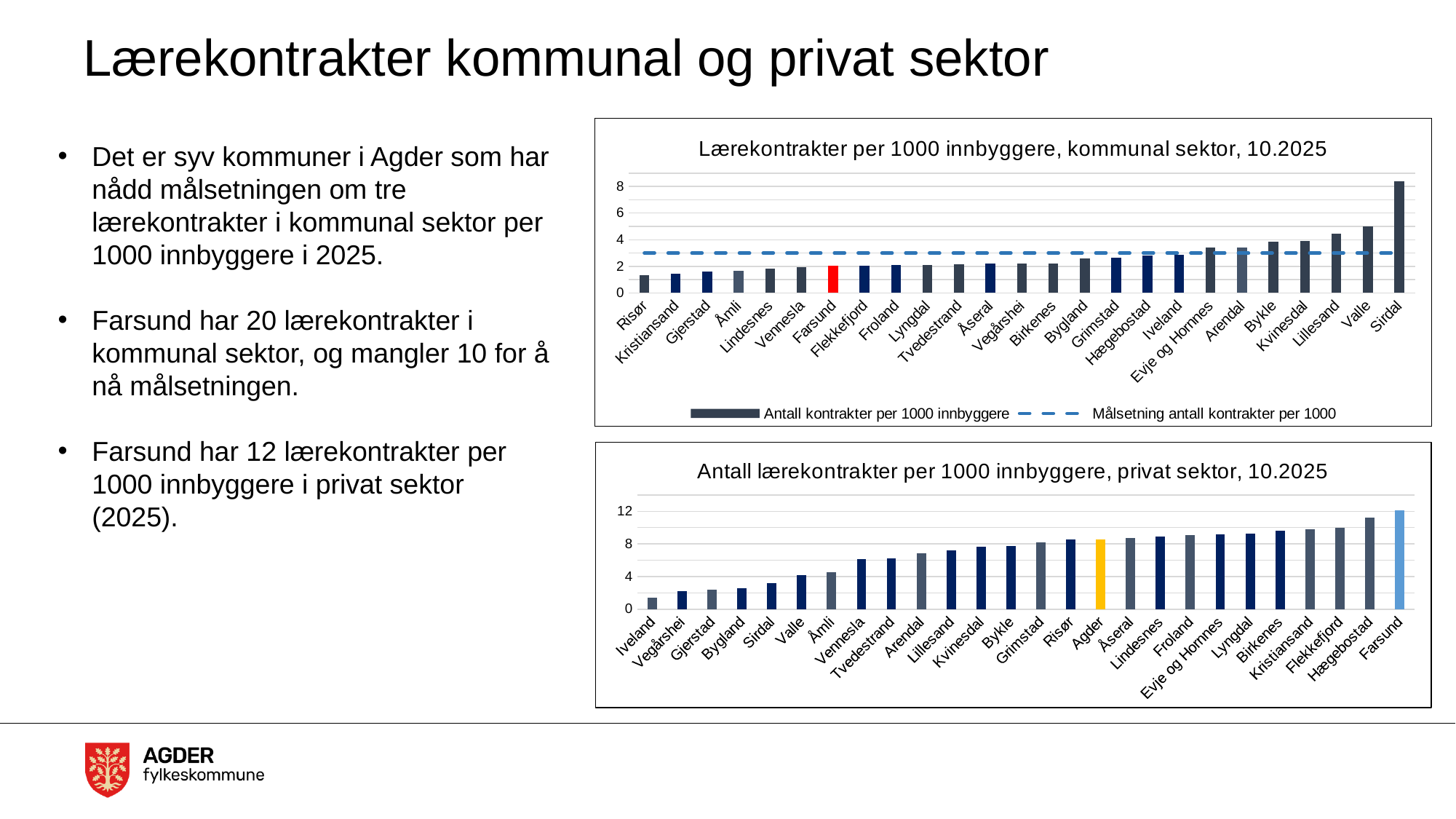
In the bottom chart (privat sektor), which is larger, the value for Sirdal or the value for Lyngdal? Lyngdal In the top chart (kommunal sektor), do the bar values rise or fall from left to right? Rise In the top chart (kommunal sektor), which municipality has the lowest value? Risør In the bottom chart (privat sektor), which municipality has the lowest value? Iveland What type of chart is the bottom chart (privat sektor)? Bar chart In the top chart (kommunal sektor), which municipality has the highest number of lærekontrakter per 1000 innbyggere? Sirdal In the top chart (kommunal sektor), what colour is the bar for Farsund? Red In the bottom chart (privat sektor), which municipality has the highest value? Farsund In the top chart (kommunal sektor), how many series does the legend list? 2 In the top chart (kommunal sektor), is the value for Farsund greater or less than 3? less In the top chart (kommunal sektor), is the value for Sirdal greater or less than 8? greater